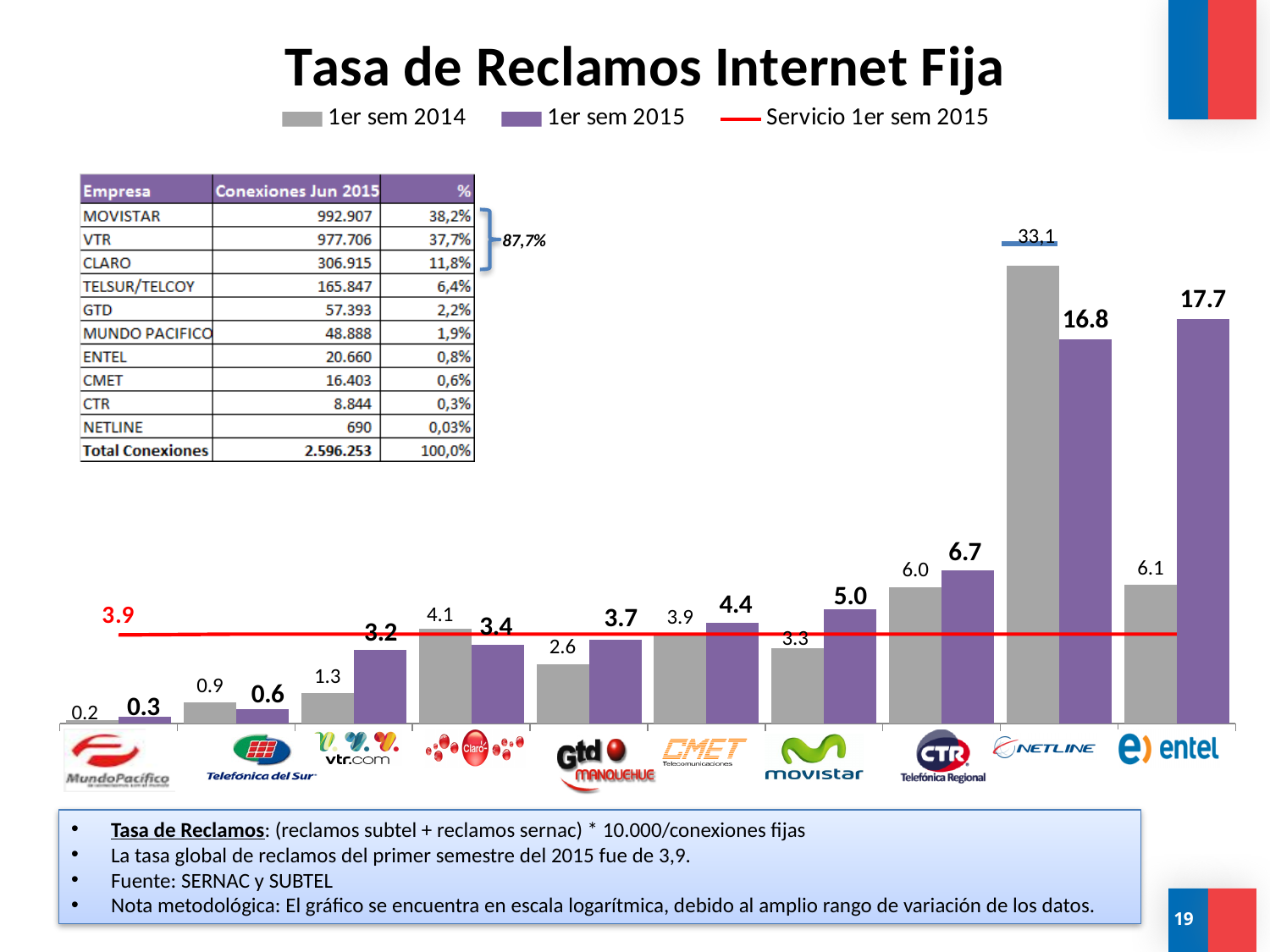
What is the 1er sem 2015 value for Entel? 17.7 Which company has the highest 1er sem 2015 value? Entel What is the difference between the 1er sem 2014 and 1er sem 2015 values for Netline? 16.3 How many entries does the chart legend list? 3 What is the 1er sem 2015 value for Movistar? 5.0 How many companies are shown on the x axis of the chart? 10 Which is larger for VTR: the 1er sem 2014 value or the 1er sem 2015 value? 1er sem 2015 What is the 1er sem 2014 value for Claro? 4.1 What value does the red 'Servicio 1er sem 2015' line mark? 3.9 What kind of chart is shown on the slide? Bar chart Which company has the lowest 1er sem 2014 value? Mundo Pacífico What is the 1er sem 2014 value for Netline? 33.1